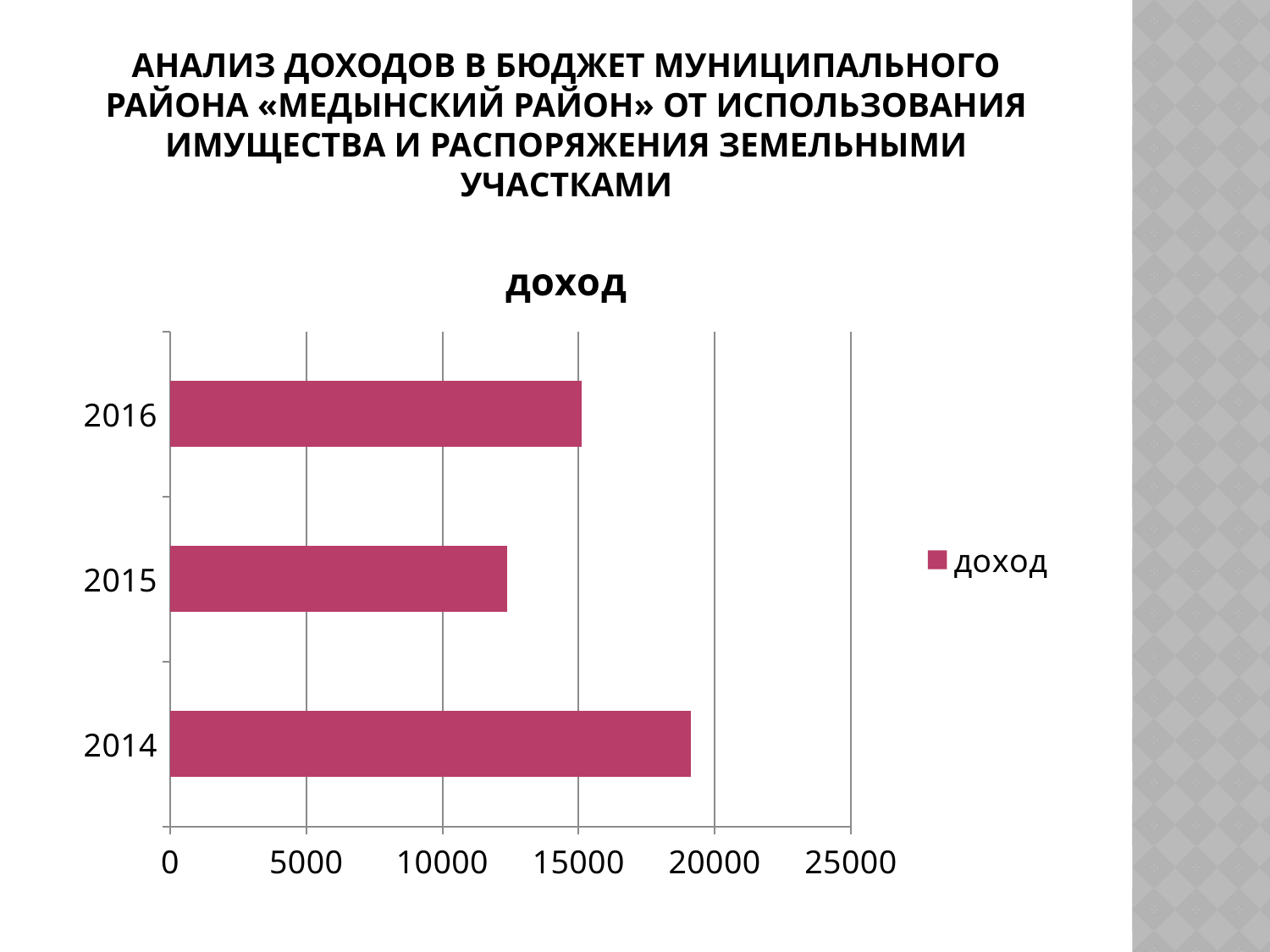
Which is larger, the value for 2015 or the value for 2016? 2016 How many years (categories) are shown in the chart? 3 What kind of chart is shown on the slide? bar chart Is the value for 2016 greater or less than 20000? less Is the value for 2015 greater or less than 15000? less Did the value rise or fall from 2014 to 2015? fall How many series does the legend list? 1 Which year has the lowest value in the chart? 2015 Which is larger, the value for 2014 or the value for 2016? 2014 Is the value for 2014 greater or less than 15000? greater Which year has the highest value in the chart? 2014 What is the title of the chart? доход